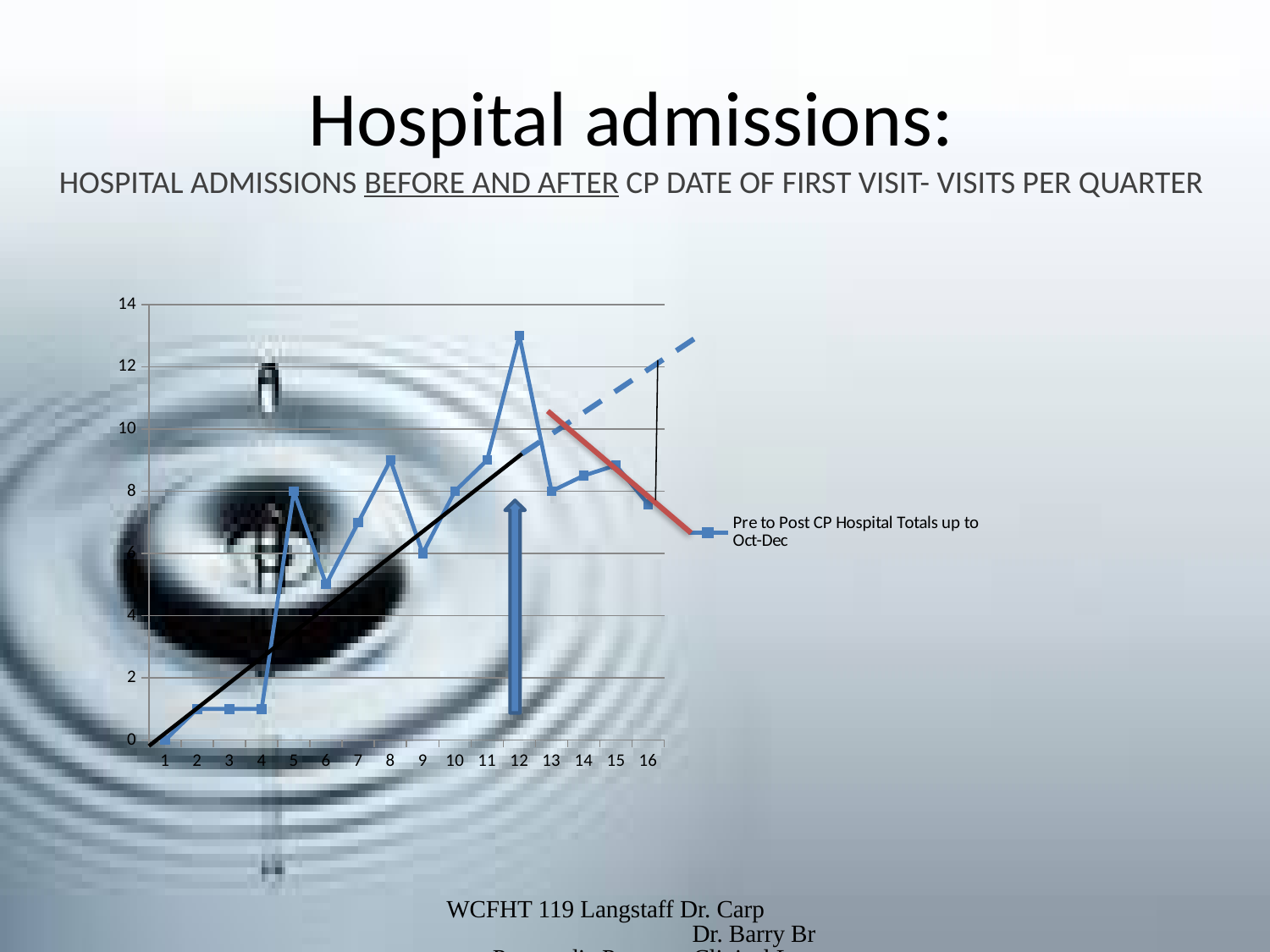
At which quarter does the plotted line have its lowest value? 1 Do the plotted values generally rise or fall from quarter 1 to quarter 12? rise How many series does the chart's legend list? 1 Is the value for quarter 8 greater or less than 8? greater Which quarter has the larger value, quarter 5 or quarter 6? quarter 5 What kind of chart is shown on the slide? line chart How many quarters are labelled along the x axis of the chart? 16 What is the legend entry for the plotted series? Pre to Post CP Hospital Totals up to Oct-Dec Is the value for quarter 3 greater or less than 2? less At which quarter does the plotted line reach its highest value? 12 What is the value plotted for quarter 1? 0 Is the value for quarter 12 greater or less than 12? greater